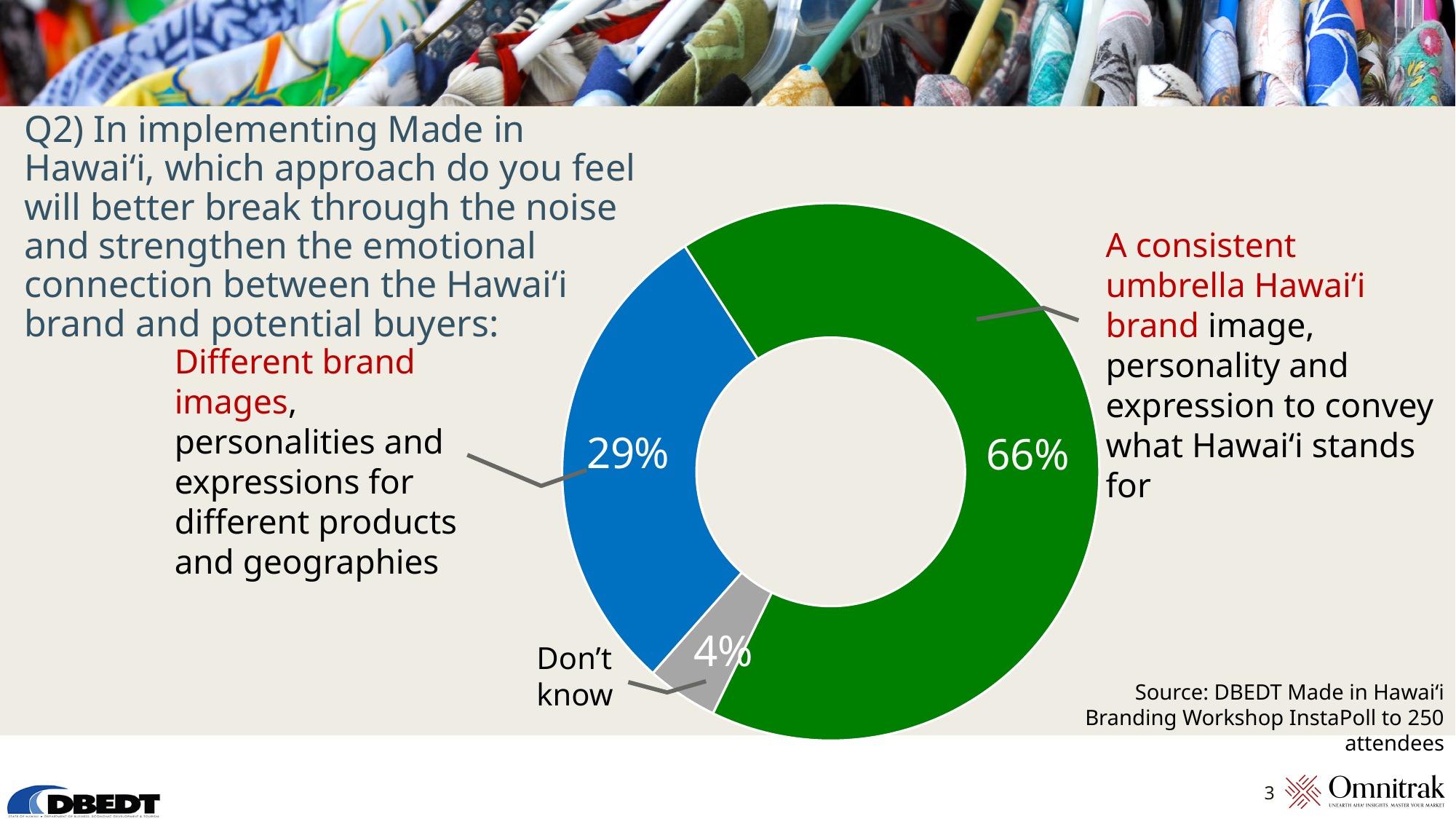
What percentage of respondents chose different brand images for different products and geographies? 29% What is the difference in percentage points between the consistent umbrella brand response and the different brand images response? 37 percentage points How many response categories are shown in the chart? 3 What type of chart is shown on the slide? Doughnut (pie) chart Is the share for different brand images greater or less than 50%? less Which response received the smallest share of respondents? Don't know What percentage of respondents answered "Don't know"? 4% Which received a larger share: different brand images or Don't know? Different brand images Which response received the largest share of respondents? A consistent umbrella Hawai‘i brand According to the source note, how many attendees were polled? 250 What colour is the slice representing the consistent umbrella Hawai‘i brand response? Green What percentage of respondents chose a consistent umbrella Hawai‘i brand? 66%